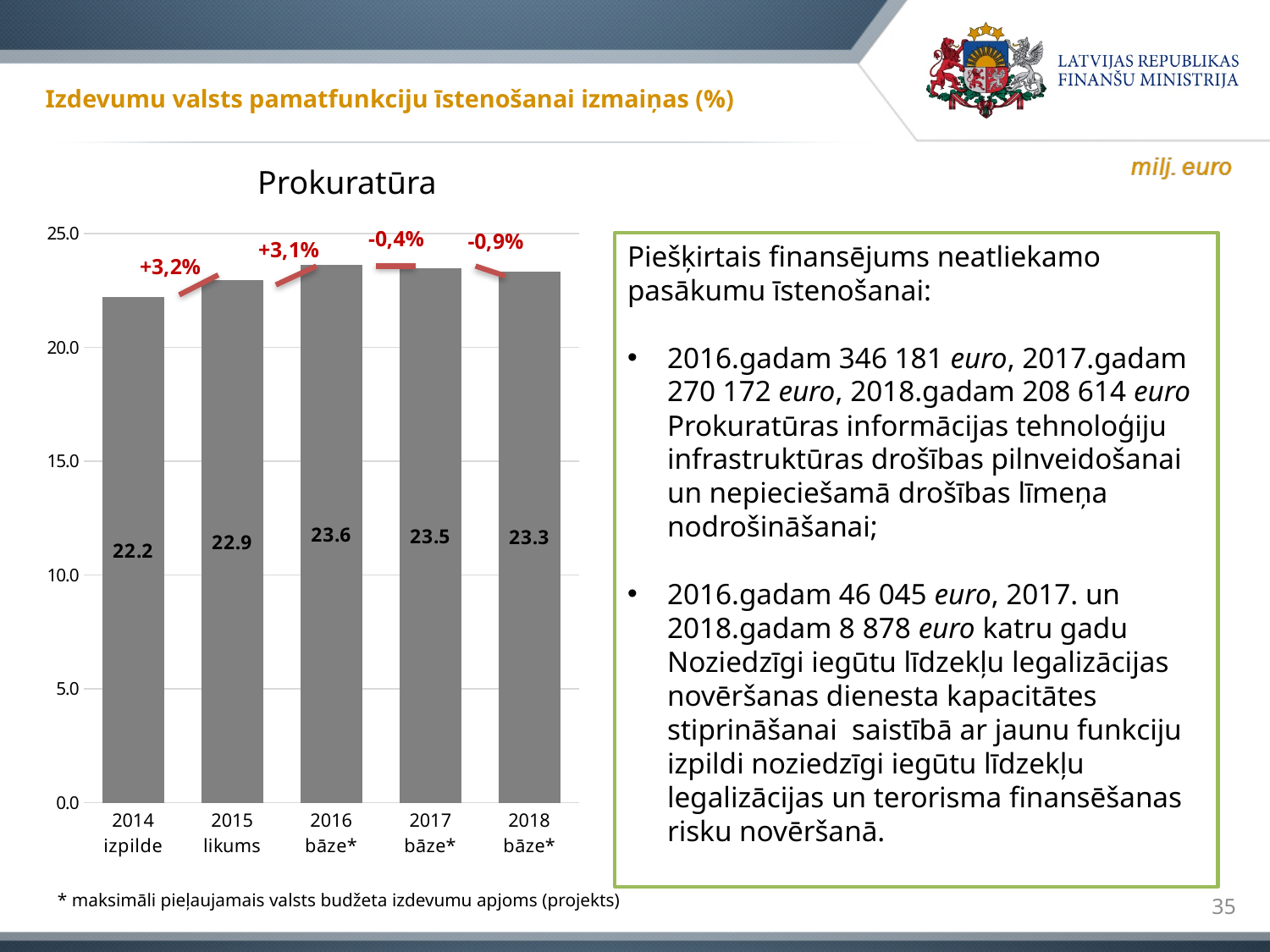
Which category has the lowest value in the Prokuratūra chart? 2014 izpilde What percentage change is shown between 2014 izpilde and 2015 likums in the Prokuratūra chart? +3,2% How many categories are shown in the Prokuratūra chart? 5 What is the title of the chart on the slide? Prokuratūra What is the difference between the values for 2016 bāze* and 2014 izpilde in the Prokuratūra chart? 1.4 What is the value for 2016 bāze* in the Prokuratūra chart? 23.6 What is the value for 2018 bāze* in the Prokuratūra chart? 23.3 What kind of chart is the Prokuratūra chart? bar chart Which category has the highest value in the Prokuratūra chart? 2016 bāze* What is the value for 2014 izpilde in the Prokuratūra chart? 22.2 Which is larger in the Prokuratūra chart: the value for 2015 likums or the value for 2017 bāze*? 2017 bāze* Is the value for 2015 likums greater or less than 20.0 in the Prokuratūra chart? greater